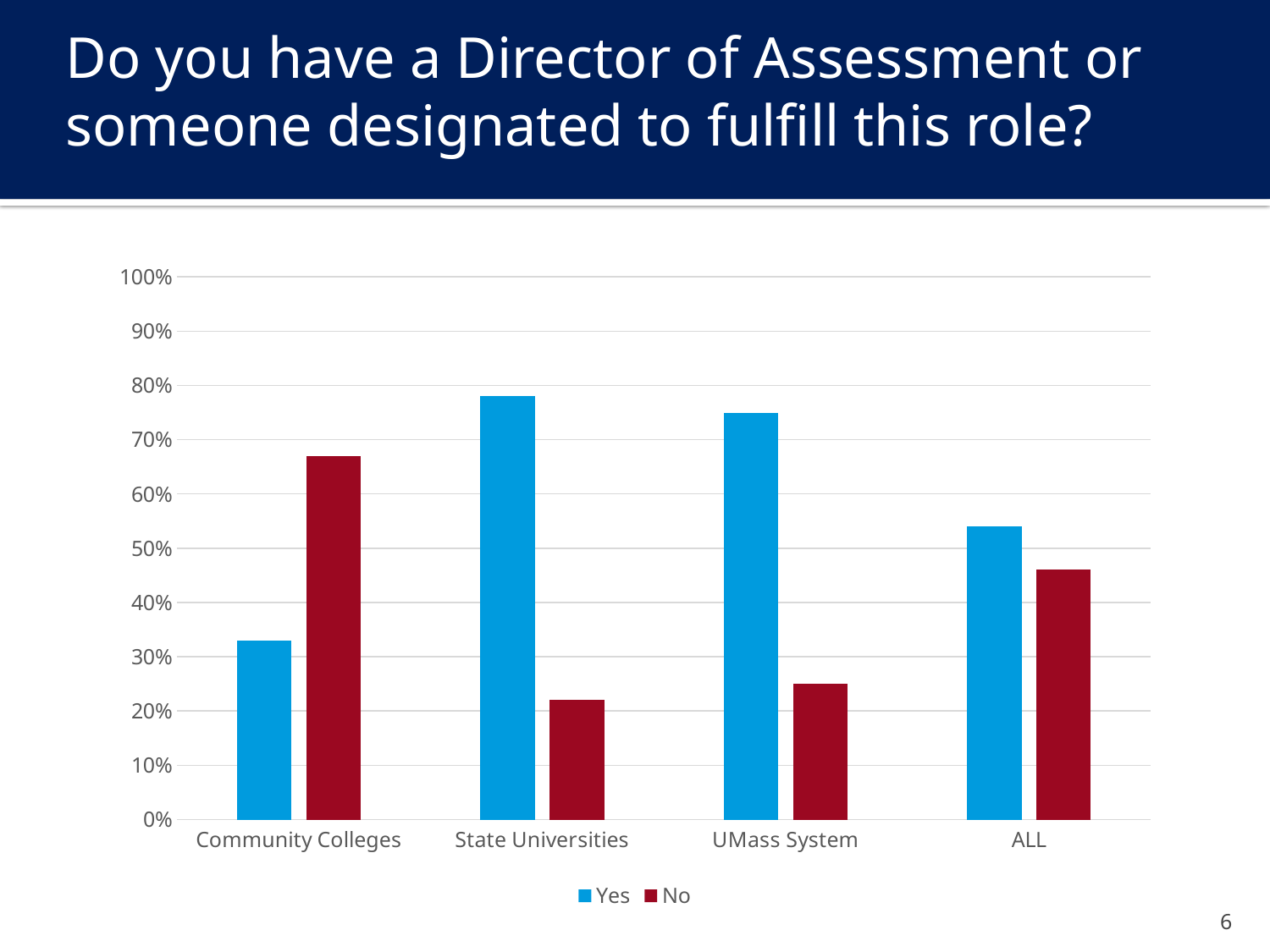
What kind of chart is shown on the slide? bar chart What colour are the "No" bars in the chart? dark red For ALL, which is larger, the "Yes" bar or the "No" bar? Yes Is the "No" value for UMass System greater or less than 30%? less How many series does the legend list? 2 Is the "No" value for Community Colleges greater or less than 60%? greater For Community Colleges, which is larger, the "Yes" bar or the "No" bar? No Which category has the lowest "Yes" bar? Community Colleges Which category has the highest "No" bar? Community Colleges Is the "Yes" value for Community Colleges greater or less than 40%? less How many categories are shown on the x axis? 4